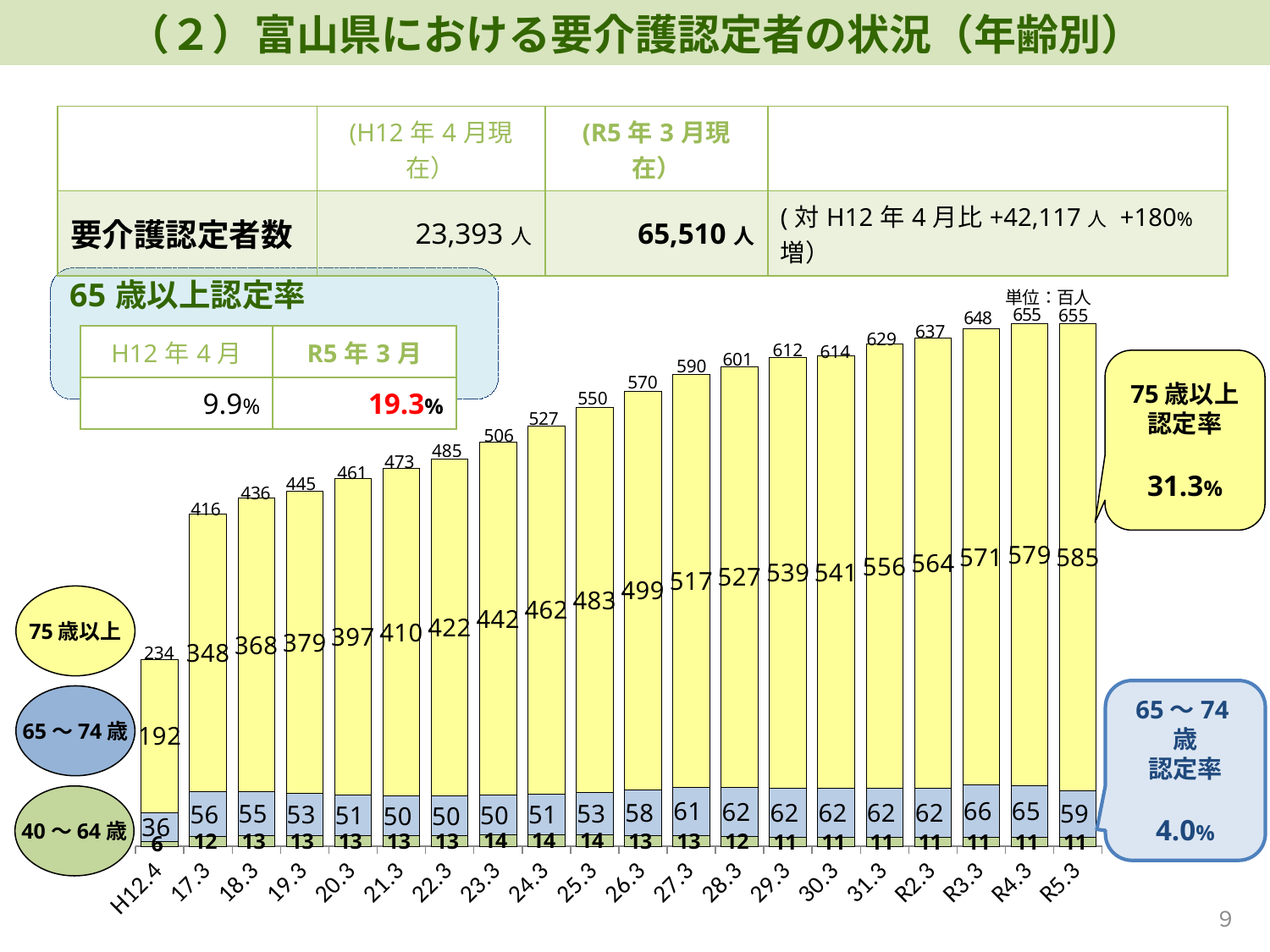
R5.3 の 75 歳以上の値はいくつですか？ 585 棒の合計値が最も小さい時点はどれですか？ H12.4 H12.4 の 65～74 歳の値はいくつですか？ 36 R5.3 の棒の合計値はいくつですか？ 655 R5.3 と H12.4 の 75 歳以上の値の差はいくつですか？ 393 グラフの横軸には何個の時点（カテゴリ）がありますか？ 20 23.3 の 40～64 歳の値はいくつですか？ 14 グラフには何系列（年齢区分）が示されていますか？ 3 グラフの単位は何ですか？ 百人 75 歳以上の値は、横軸に沿って増加していますか、減少していますか？ 増加 65～74 歳の値が最も大きい時点はどれですか？ R3.3 このグラフはどの種類のグラフですか？ 積み上げ棒グラフ